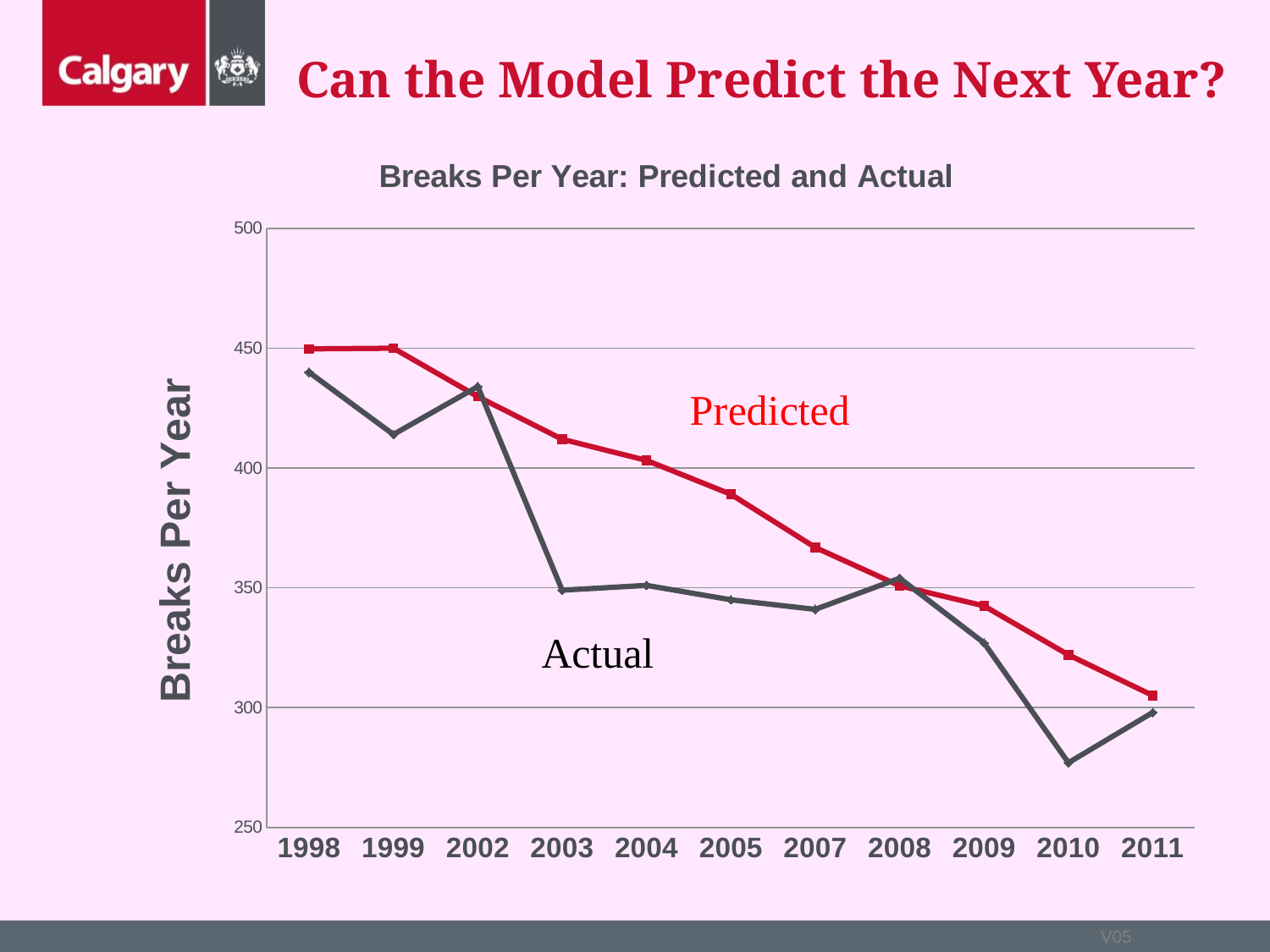
How many series are plotted on the chart? 2 How many years are shown along the x axis? 11 What is the title of the chart? Breaks Per Year: Predicted and Actual In 2003, which is larger, the Predicted value or the Actual value? Predicted What is the label on the vertical axis? Breaks Per Year Is the Actual value for 2009 greater or less than 350? less In which year is the Actual series at its lowest? 2010 What kind of chart is shown on the slide? Line chart Does the Predicted series rise or fall from 1998 to 2011? Fall Is the Actual value for 2010 greater or less than 300? less Is the Predicted value for 2007 greater or less than 350? greater